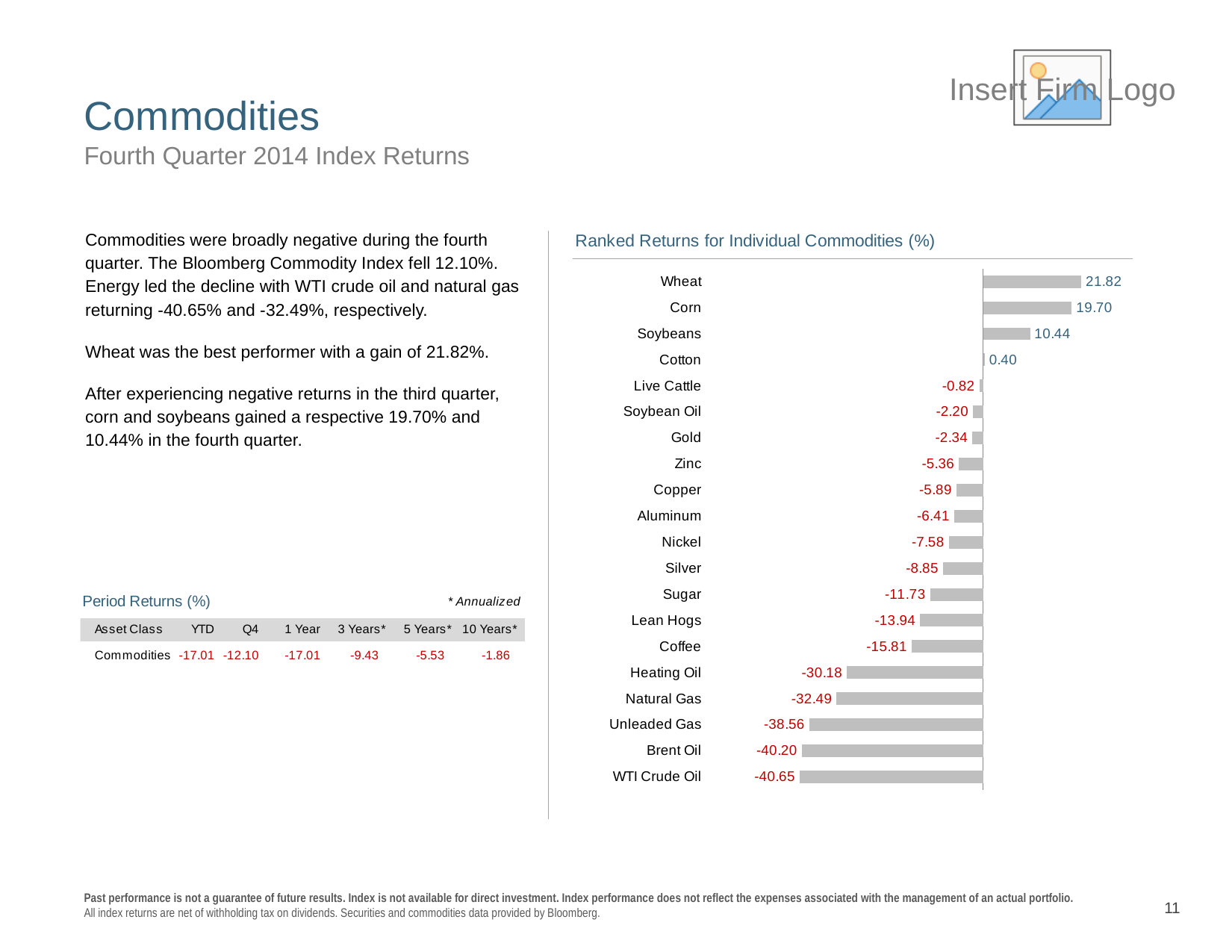
In the Ranked Returns for Individual Commodities chart, which has the higher return, Soybeans or Cotton? Soybeans How many commodities are shown in the Ranked Returns for Individual Commodities chart? 20 In the Ranked Returns for Individual Commodities chart, which has the lower return, Heating Oil or Coffee? Heating Oil What is the return shown for Gold in the Ranked Returns for Individual Commodities chart? -2.34 What type of chart is the Ranked Returns for Individual Commodities chart? Bar chart Which commodity has the lowest return in the Ranked Returns for Individual Commodities chart? WTI Crude Oil In the Ranked Returns for Individual Commodities chart, what is the difference between the returns for Brent Oil and WTI Crude Oil? 0.45 In the Ranked Returns for Individual Commodities chart, what is the difference between the returns for Wheat and Corn? 2.12 What is the title of the chart on the slide? Ranked Returns for Individual Commodities (%) What is the return shown for Wheat in the Ranked Returns for Individual Commodities chart? 21.82 What is the return shown for Natural Gas in the Ranked Returns for Individual Commodities chart? -32.49 Which commodity has the highest return in the Ranked Returns for Individual Commodities chart? Wheat